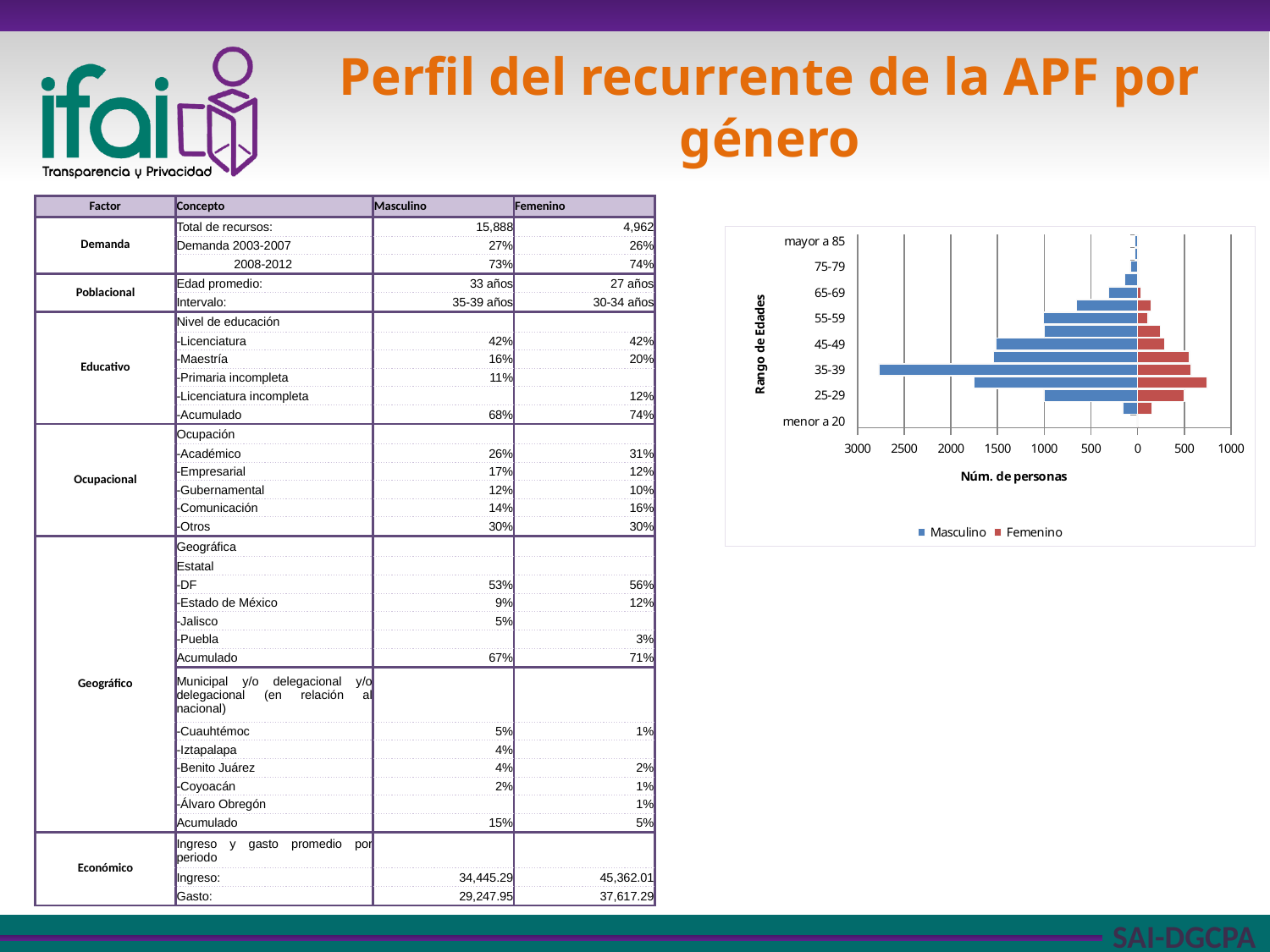
For the 35-39 age range, which series has the larger value, Masculino or Femenino? Masculino Is the Femenino value for the 65-69 age range greater or less than 500? less Which age range has the highest Masculino value in the chart? 35-39 What are the two series named in the chart legend? Masculino and Femenino What kind of chart is shown on the slide? bar chart How many series does the chart legend list? 2 Is the Masculino value for the 75-79 age range greater or less than 500? less Is the Masculino value for the 65-69 age range greater or less than 500? less Which Masculino value is larger, the 35-39 age range or the 25-29 age range? 35-39 What is the title of the chart's horizontal axis? Núm. de personas